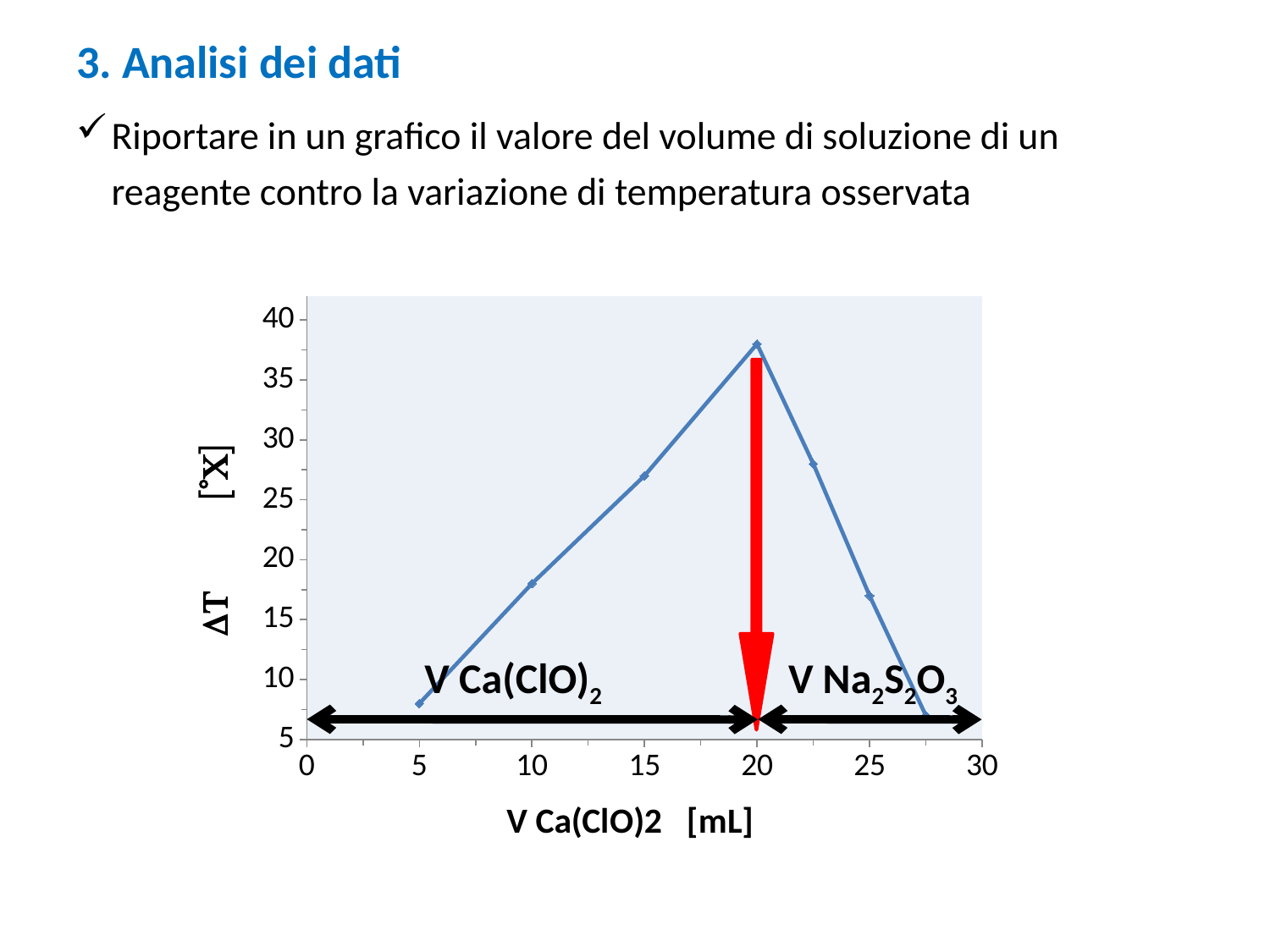
Is the ΔT value at V Ca(ClO)2 = 20 mL greater or less than 35? greater Is the ΔT value at V Ca(ClO)2 = 25 mL greater or less than 20? less How many data points are plotted on the line? 7 Does ΔT rise or fall as V Ca(ClO)2 increases from 5 to 20 mL? rise What is the label of the x axis? V Ca(ClO)2 [mL] What kind of chart is shown on the slide? line chart Is the ΔT value at V Ca(ClO)2 = 15 mL greater or less than 25? greater At which V Ca(ClO)2 value does ΔT reach its highest point? 20 What is the label of the y axis? ΔT [°C] Which has a larger ΔT: V Ca(ClO)2 = 10 mL or V Ca(ClO)2 = 15 mL? 15 mL